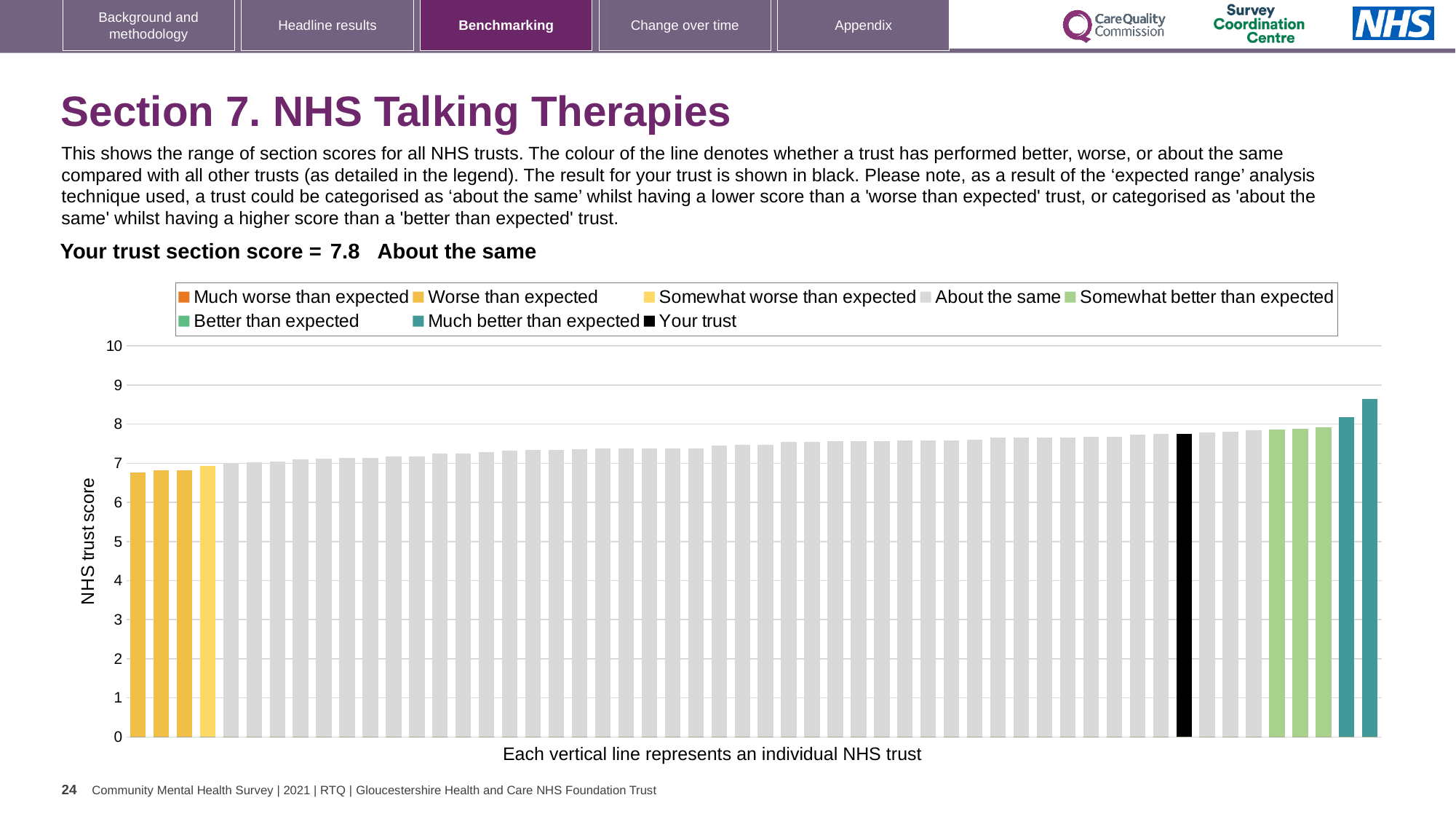
Do the bar values rise or fall from left to right along the x axis? rise What is the section score for your trust? 7.8 How many entries does the chart legend list? 8 What colour is the bar representing your trust? black Which benchmarking category is your trust placed in for this section? About the same How many bars are coloured 'Somewhat better than expected' (light green)? 3 What kind of chart is shown on the slide? bar chart Is the value of the shortest bar greater or less than 7? less What is the label on the y axis of the chart? NHS trust score Is the value for your trust greater or less than 7? greater How many bars are coloured 'Much better than expected' (teal)? 2 Is the value of the tallest bar greater or less than 8? greater